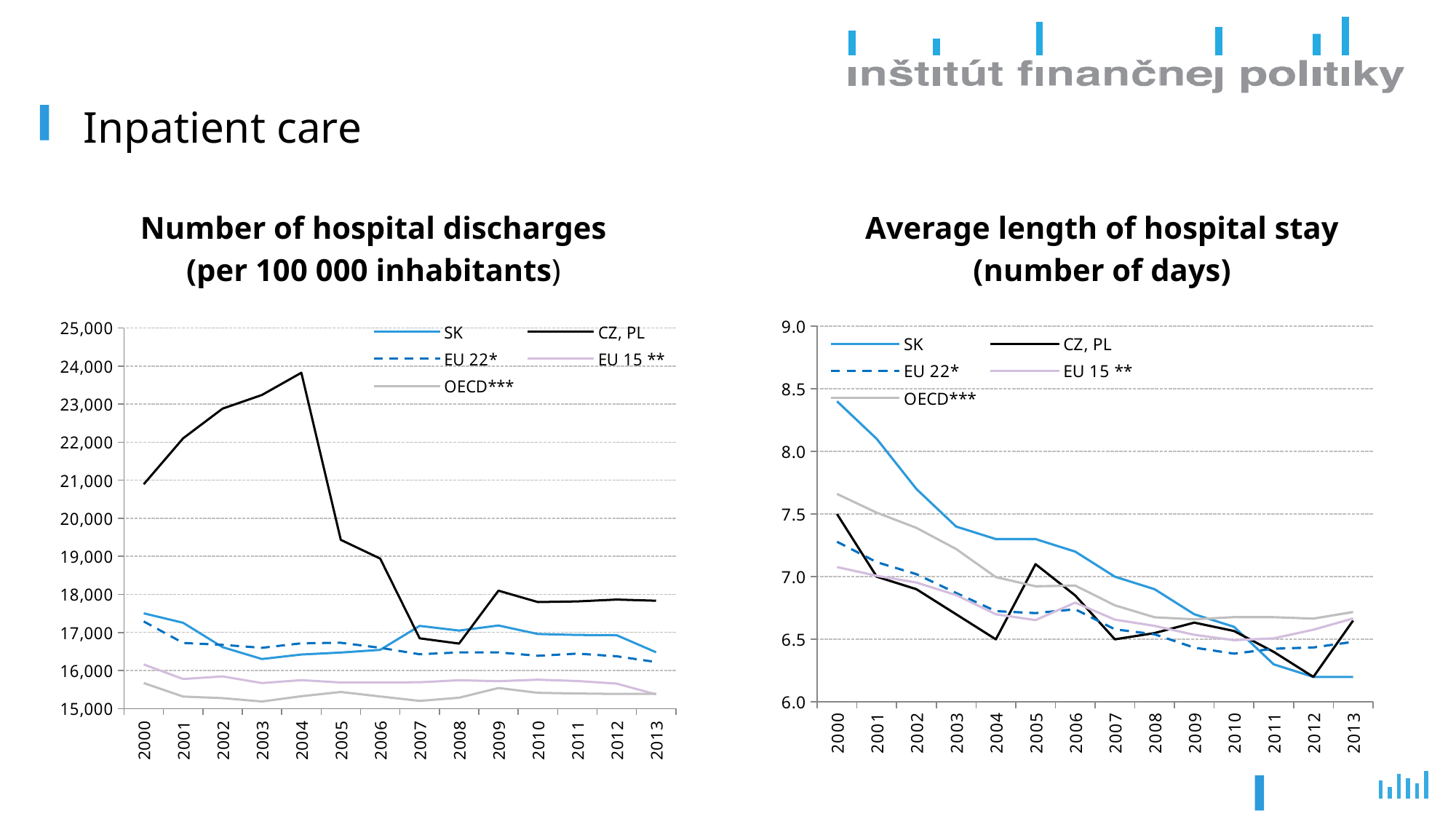
What kind of chart is the 'Number of hospital discharges (per 100 000 inhabitants)' chart? line chart In the 'Number of hospital discharges' chart, is the SK value in 2013 greater or less than 17,000? less In the 'Number of hospital discharges' chart, in which year does the CZ, PL series reach its peak? 2004 In the 'Average length of hospital stay' chart, is the SK value in 2000 greater or less than 8.0? greater How many years are shown on the x axis of the 'Number of hospital discharges' chart? 14 In the 'Average length of hospital stay' chart, does the SK series rise or fall from 2000 to 2013? fall In the 'Average length of hospital stay' chart, which series has the highest value in 2000? SK In the 'Number of hospital discharges' chart, is the CZ, PL value in 2004 greater or less than 23,000? greater In the 'Average length of hospital stay' chart, which is larger in 2000: SK or EU 22*? SK How many series does the legend of the 'Average length of hospital stay (number of days)' chart list? 5